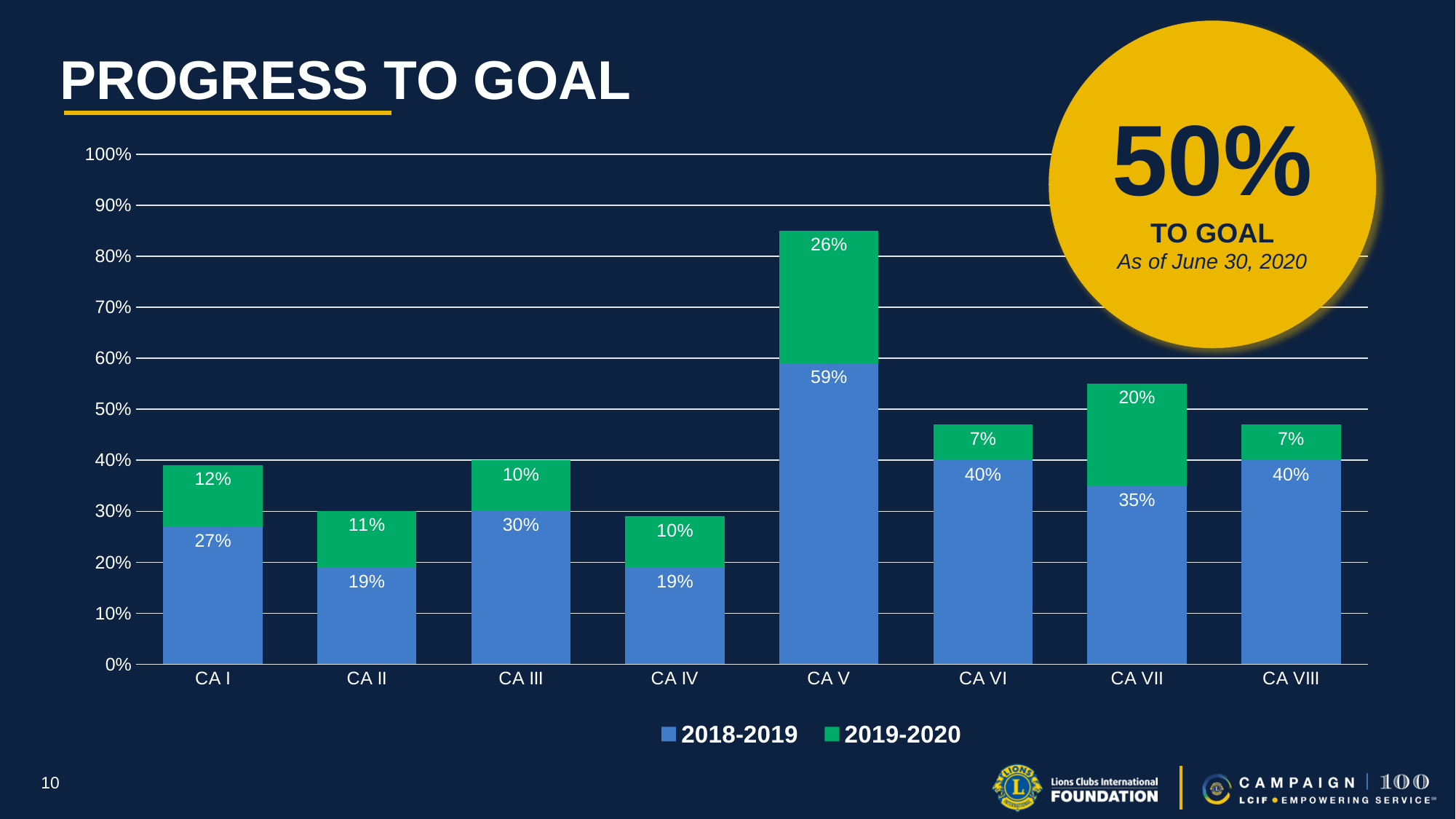
What is the total of the stacked bar for CA V? 85% What is the difference between the 2018-2019 values for CA V and CA VII? 24% Which is larger, the 2019-2020 value for CA I or for CA III? CA I What is the 2019-2020 value for CA VII? 20% What is the total of the stacked bar for CA I? 39% Which category has the lowest 2019-2020 value? CA VI and CA VIII (7%) How many series does the legend list? 2 What is the 2018-2019 value for CA V? 59% Which category has the highest 2018-2019 value? CA V What is the 2018-2019 value for CA II? 19% How many categories are shown on the x axis? 8 What kind of chart is shown on the slide? Stacked bar chart